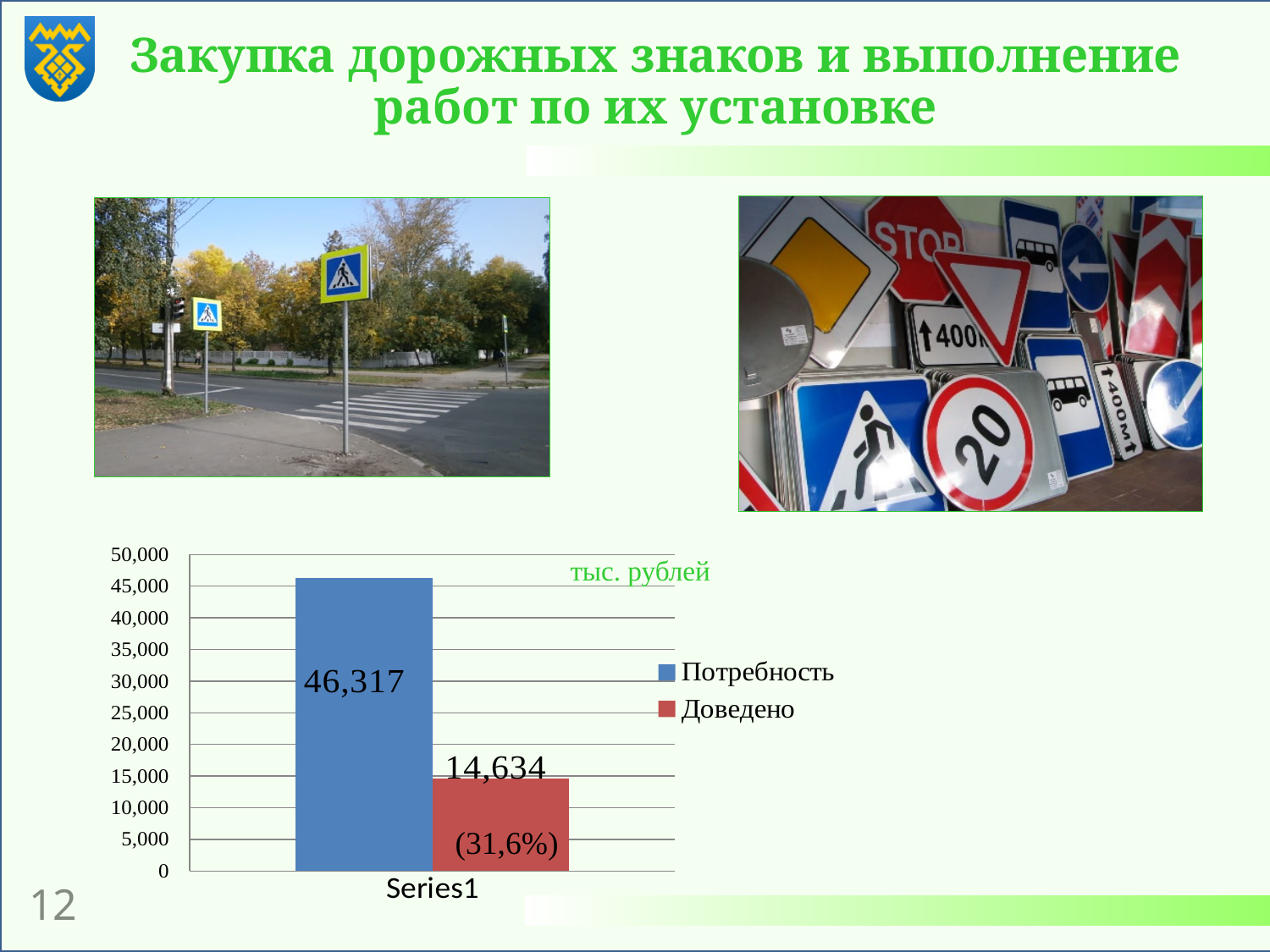
Which series has the higher value, Потребность or Доведено? Потребность What colour is the Потребность bar? blue What is the value of the Потребность bar? 46,317 What is the difference between the Потребность and Доведено values? 31,683 What percentage is printed on the Доведено bar? (31,6%) Is the value for Потребность greater or less than 45,000? greater How many series does the legend list? 2 What kind of chart is shown on the slide? bar chart What unit label is shown on the chart? тыс. рублей Is the value for Доведено greater or less than 15,000? less Which series has the lowest value on the chart? Доведено What is the value of the Доведено bar? 14,634